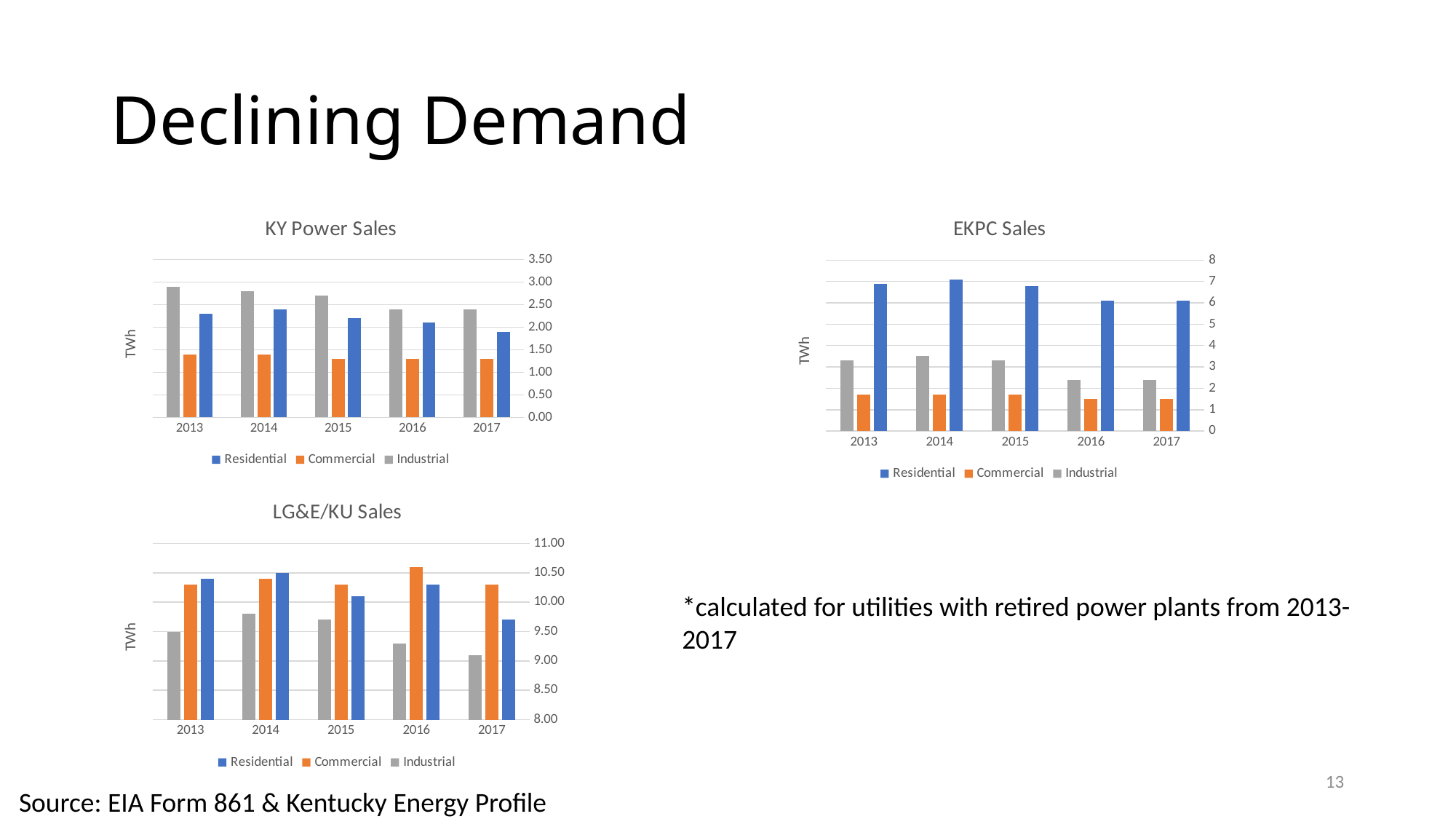
In the LG&E/KU Sales chart, how many years are shown on the x axis? 5 In the KY Power Sales chart, which year has the lowest Residential value? 2017 In the KY Power Sales chart, do the Industrial values rise or fall from 2013 to 2017? fall In the LG&E/KU Sales chart, which year has the highest Commercial value? 2016 In the EKPC Sales chart, what is the label on the vertical axis? TWh In the KY Power Sales chart, is the Industrial value for 2013 greater or less than 2.50? greater In the KY Power Sales chart, what kind of chart is used? Bar chart In the LG&E/KU Sales chart, which is larger in 2016, Commercial or Industrial? Commercial In the EKPC Sales chart, is the Residential value for 2014 greater or less than 6? greater In the EKPC Sales chart, how many series does the legend list? 3 In the EKPC Sales chart, is the Commercial value for 2016 greater or less than 2? less In the EKPC Sales chart, which year has the highest Residential value? 2014